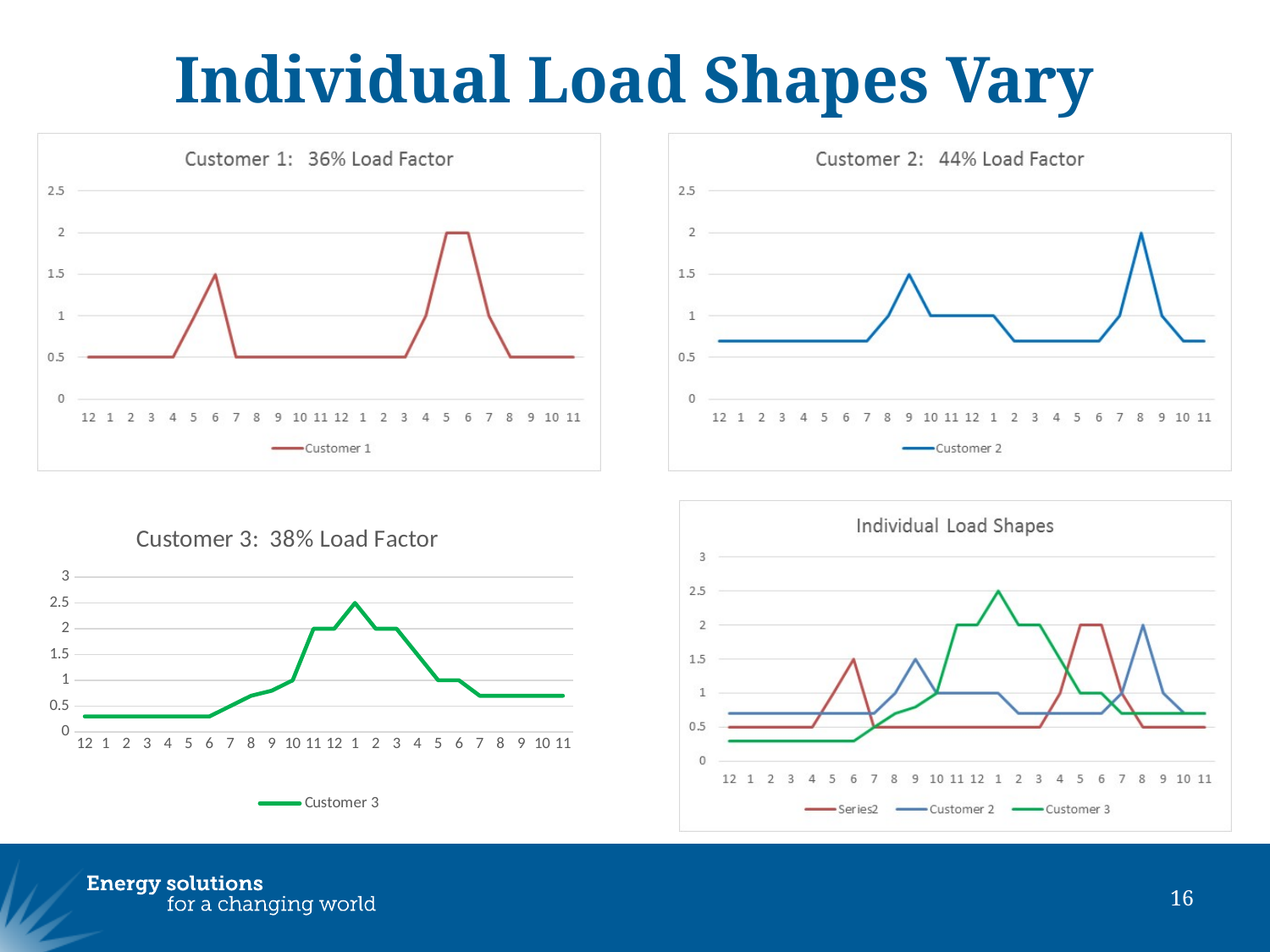
What kind of chart is the 'Customer 1: 36% Load Factor' chart? line chart In the 'Customer 1: 36% Load Factor' chart, is the value at the first hour (12) greater or less than 1? less In the 'Individual Load Shapes' chart, which series reaches the highest peak? Customer 3 What is the difference between the peak value in the Customer 3 chart and the peak value in the Customer 1 chart? 0.5 In the 'Customer 3: 38% Load Factor' chart, is the value at the first hour (12) greater or less than 0.5? less In the 'Customer 2: 44% Load Factor' chart, what is the highest value the line reaches? 2 In the 'Customer 1: 36% Load Factor' chart, what is the highest value the line reaches? 2 Which is larger: the peak value in the Customer 1 chart or the peak value in the Customer 3 chart? Customer 3 In the 'Individual Load Shapes' chart, how many series does the legend list? 3 How many hourly points are plotted along the x axis of the 'Customer 2: 44% Load Factor' chart? 24 According to the title of the top-right chart, what is Customer 2's load factor? 44%